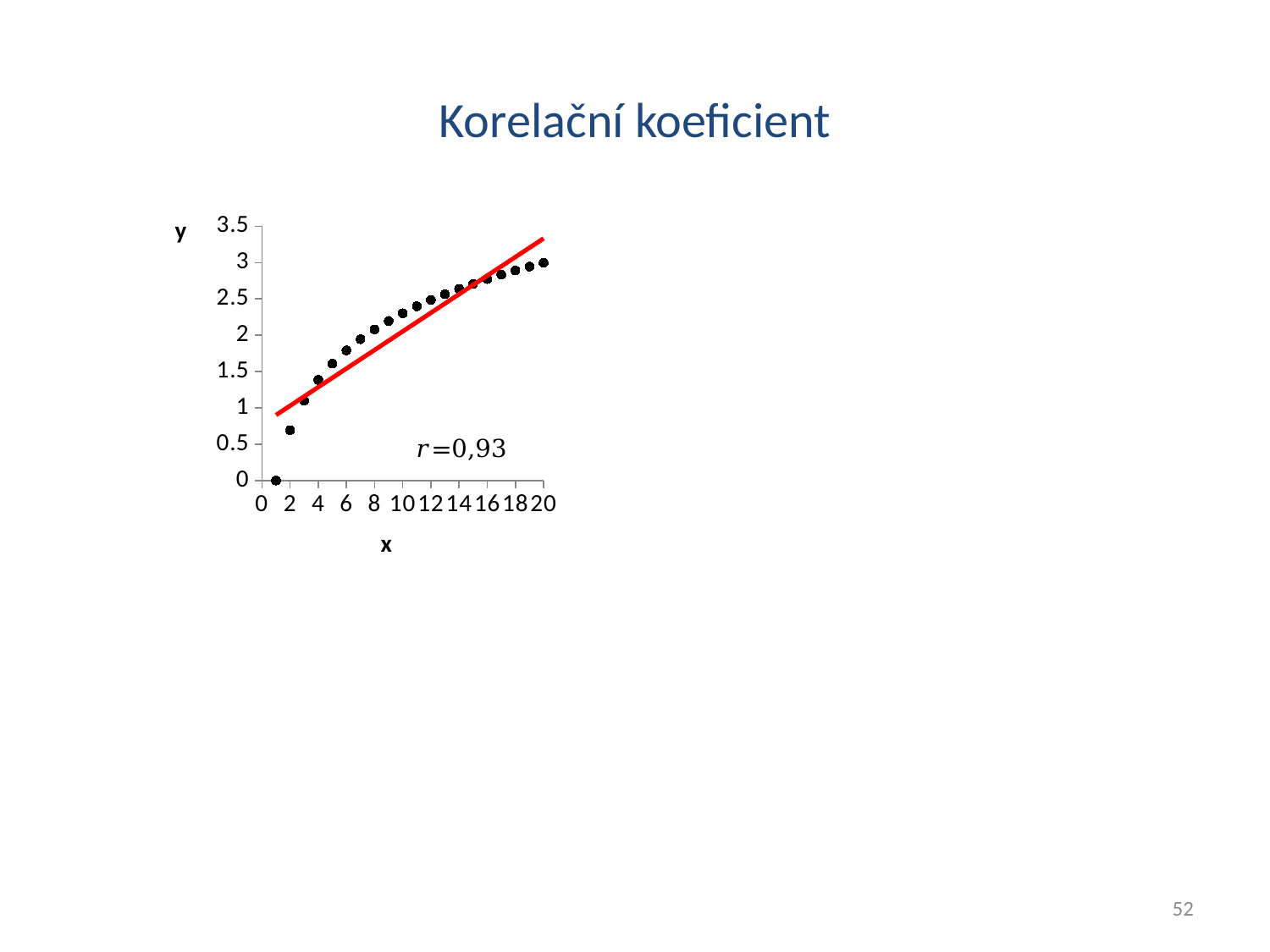
Is the y value of the point at x = 10 greater or less than 2? greater At which x value does the plotted point have the lowest y value? 1 Do the plotted y values rise or fall as x increases? rise What kind of chart is shown on the slide? scatter plot Is the y value of the point at x = 20 greater or less than 2.5? greater What is the highest tick value shown on the y axis? 3.5 Is the y value of the point at x = 4 greater or less than 2? less At which x value does the plotted point have the highest y value? 20 Which point has a larger y value, the one at x = 6 or the one at x = 14? x = 14 What is the value of the correlation coefficient r shown on the chart? 0,93 What colour is the fitted line drawn through the points? red